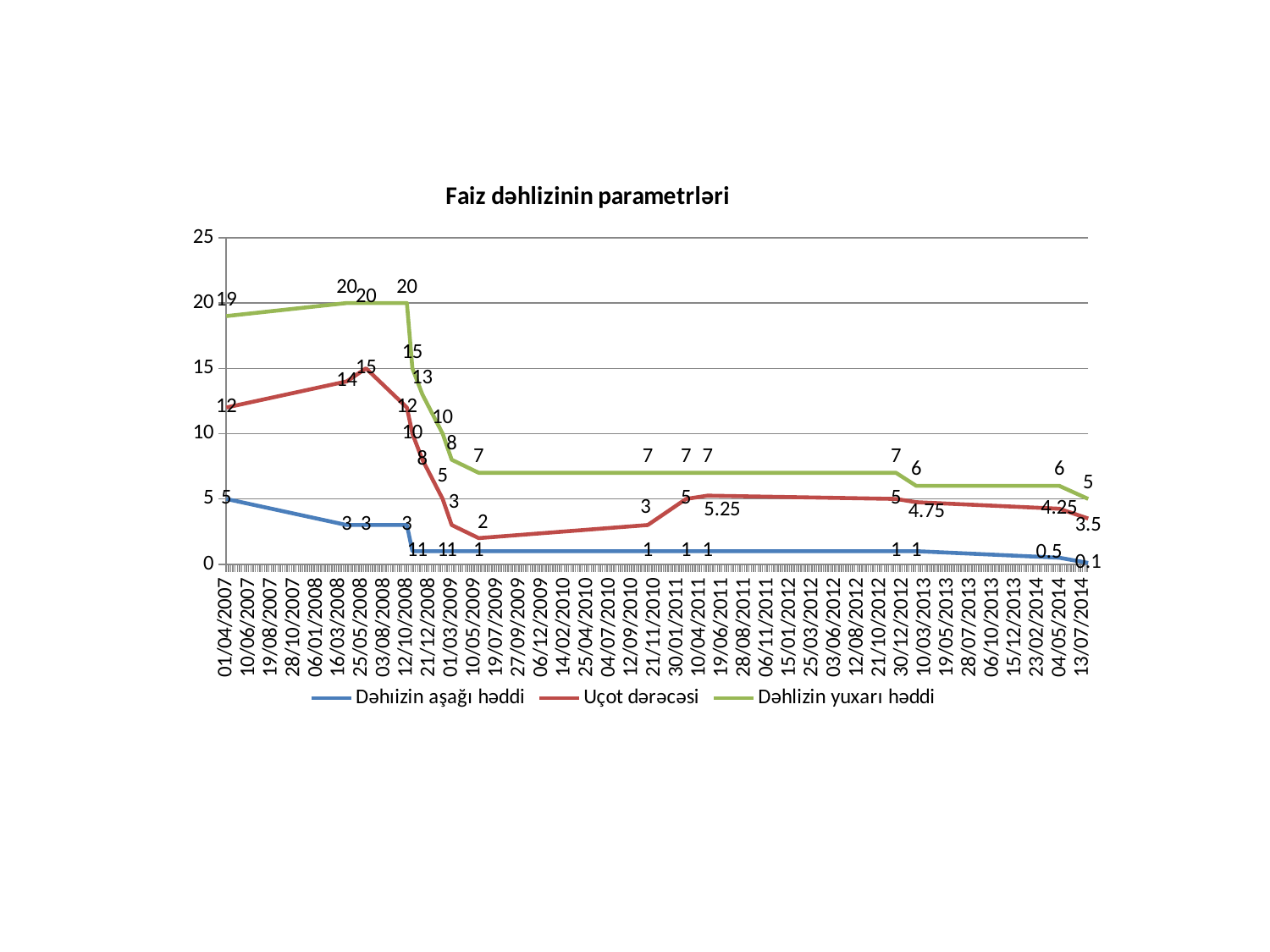
Which series is drawn in green? Dəhlizin yuxarı həddi What is the last value of the Uçot dərəcəsi series, at 13/07/2014? 3.5 How many series does the legend list? 3 What is the lowest value reached by the Dəhıizin aşağı həddi series? 0.1 Overall, do the values of the Dəhlizin yuxarı həddi series rise or fall from left to right? fall What is the highest value reached by the Uçot dərəcəsi series? 15 What is the first value of the Dəhlizin yuxarı həddi series, at 01/04/2007? 19 What kind of chart is shown on the slide? line chart What is the difference between the highest value of Dəhlizin yuxarı həddi and the highest value of Uçot dərəcəsi? 5 What is the title of the chart? Faiz dəhlizinin parametrləri What is the highest value reached by the Dəhlizin yuxarı həddi series? 20 What is the last value of the Dəhlizin yuxarı həddi series, at 13/07/2014? 5